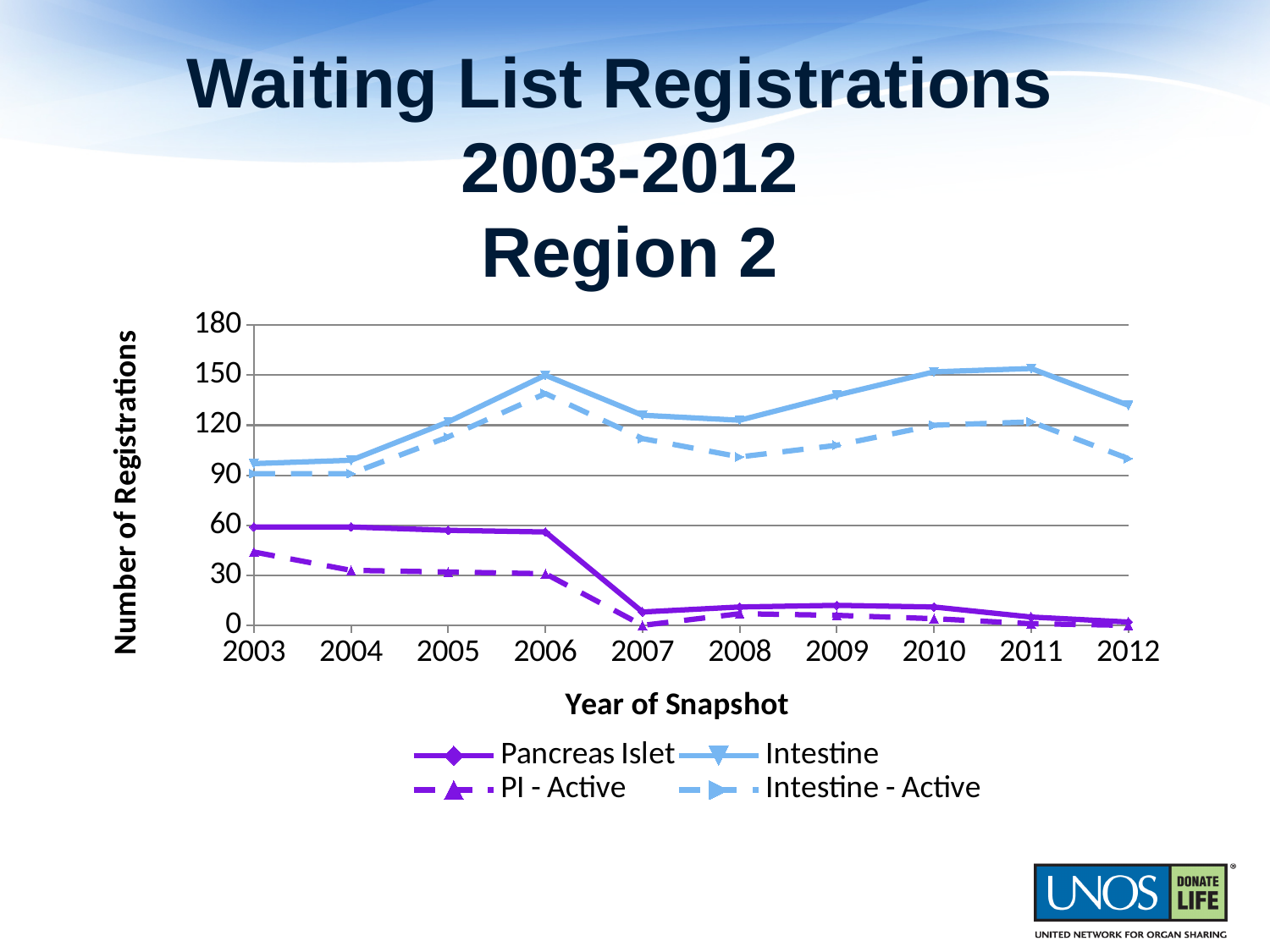
In which year does the Intestine - Active series reach its highest value? 2006 Is the value for PI - Active in 2003 greater or less than 30? greater Is the value for Intestine - Active in 2006 greater or less than 120? greater Is the value for Pancreas Islet in 2007 greater or less than 30? less Which is larger in 2006, the Intestine value or the Pancreas Islet value? Intestine How many years are plotted along the x axis? 10 What is the title of the x axis? Year of Snapshot How many series does the legend list? 4 What is the title of the y axis? Number of Registrations Does the Pancreas Islet series rise or fall overall from 2003 to 2012? fall What kind of chart is shown on the slide? line chart